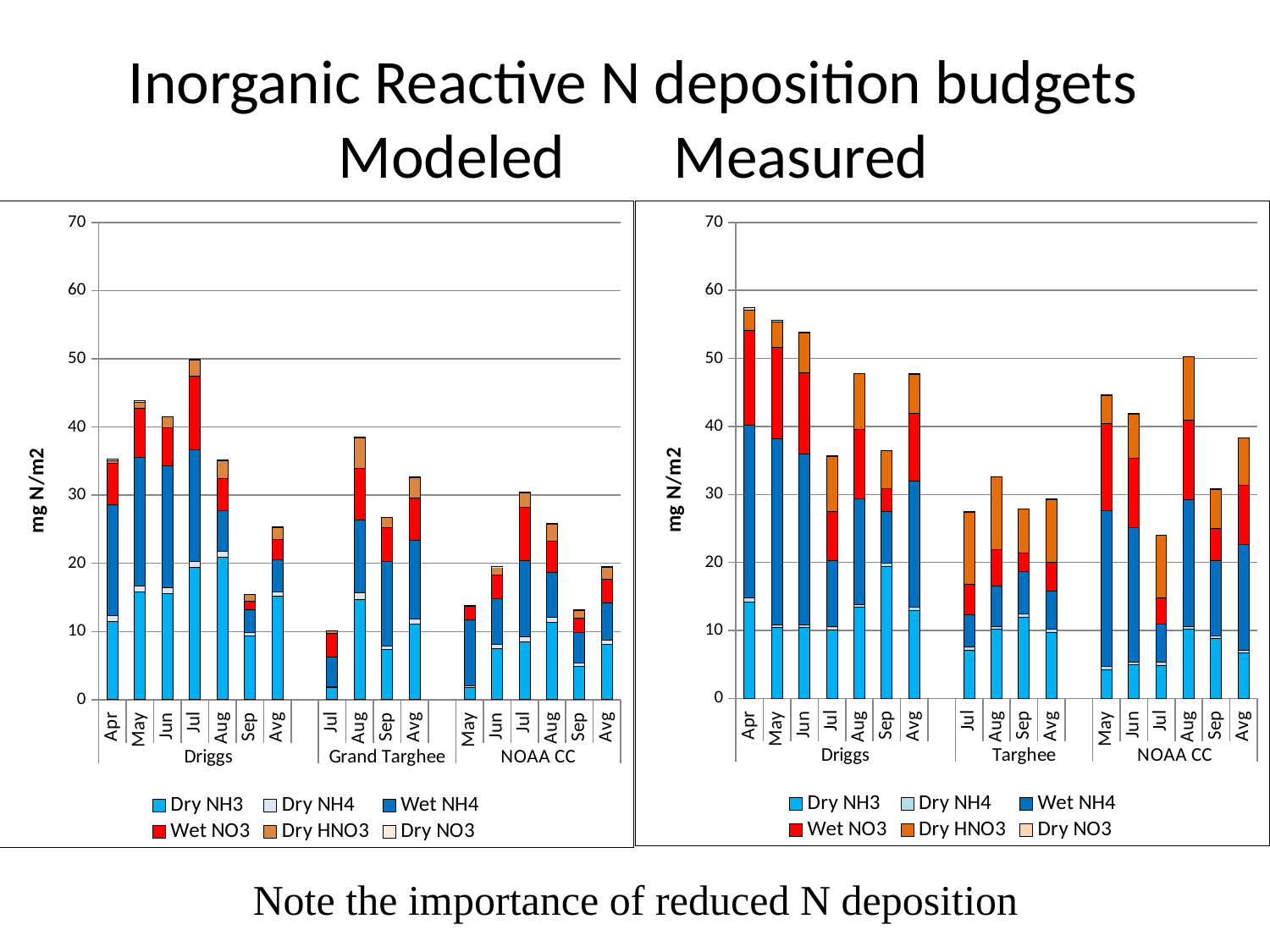
How many series does the legend of the Measured chart on the right list? 6 In the Measured chart on the right, which bar has the highest total? Driggs Apr In the Modeled chart on the left, which bar has the highest total? Driggs Jul In the Modeled chart on the left, is the total for Driggs Jul greater or less than 40? greater In the Measured chart on the right, which has the larger total, Driggs Jun or Targhee Aug? Driggs Jun What kind of chart is the Modeled chart on the left? stacked bar chart In the Measured chart on the right, is the total for NOAA CC Aug greater or less than 40? greater In the Modeled chart on the left, how many bars are plotted for the Driggs site? 7 In the Modeled chart on the left, which bar has the lowest total? Grand Targhee Jul In the Measured chart on the right, how many bars are plotted for the Targhee site? 4 In the Modeled chart on the left, which has the larger total, Driggs May or Driggs Sep? Driggs May What is the y-axis label on the Measured chart on the right? mg N/m2